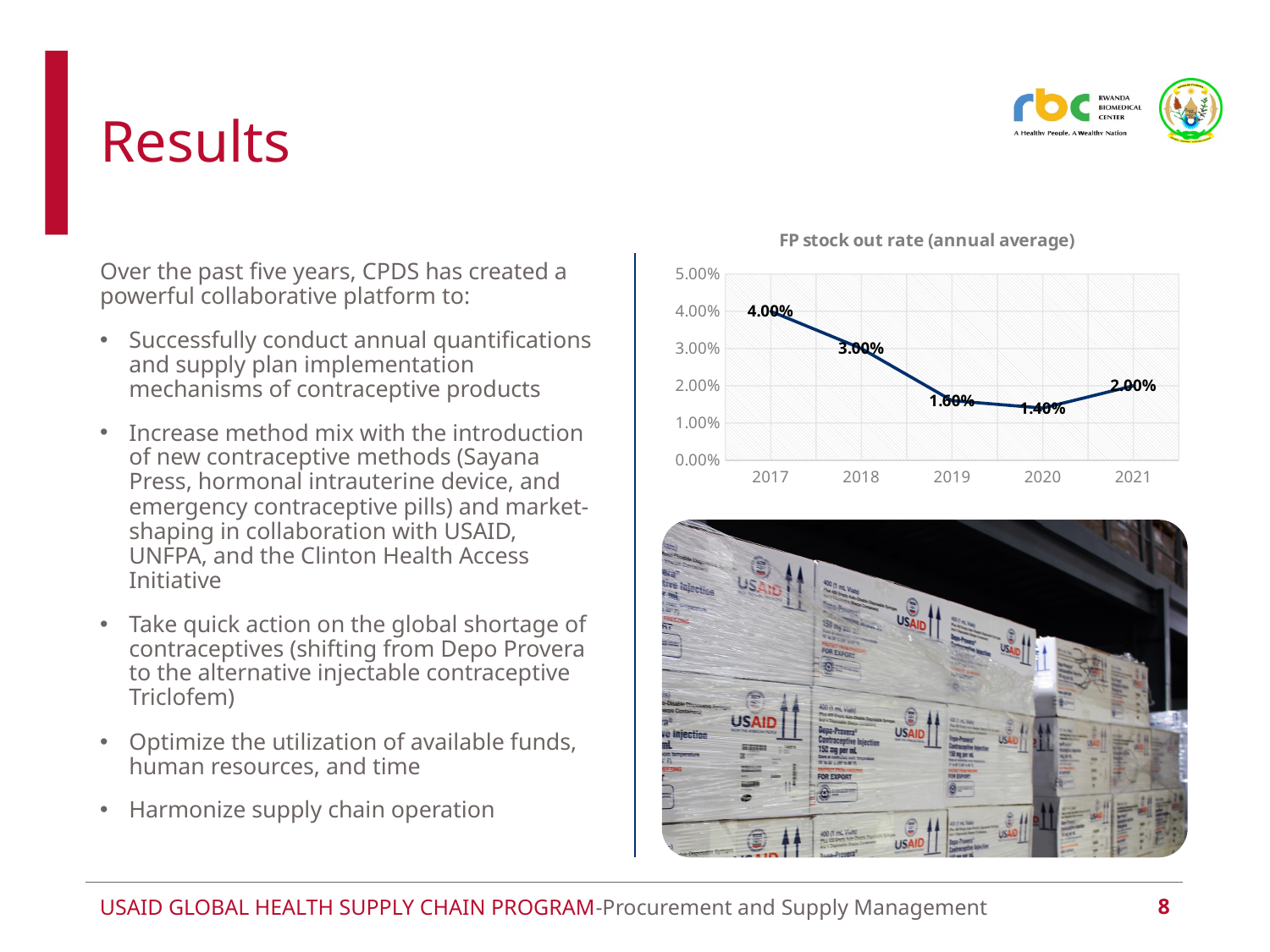
What is the difference between the FP stock out rate in 2021 and in 2020? 0.60% What is the FP stock out rate for 2019? 1.60% Which year has the highest FP stock out rate? 2017 How many years are plotted in the FP stock out rate chart? 5 Is the FP stock out rate for 2020 greater or less than 2.00%? less What kind of chart is used to show the FP stock out rate? line chart Which year has the lowest FP stock out rate? 2020 What is the FP stock out rate for 2021? 2.00% What is the FP stock out rate for 2017? 4.00% What is the difference between the FP stock out rate in 2017 and in 2018? 1.00% What is the title of the chart on the slide? FP stock out rate (annual average) Which year has a higher FP stock out rate, 2018 or 2021? 2018